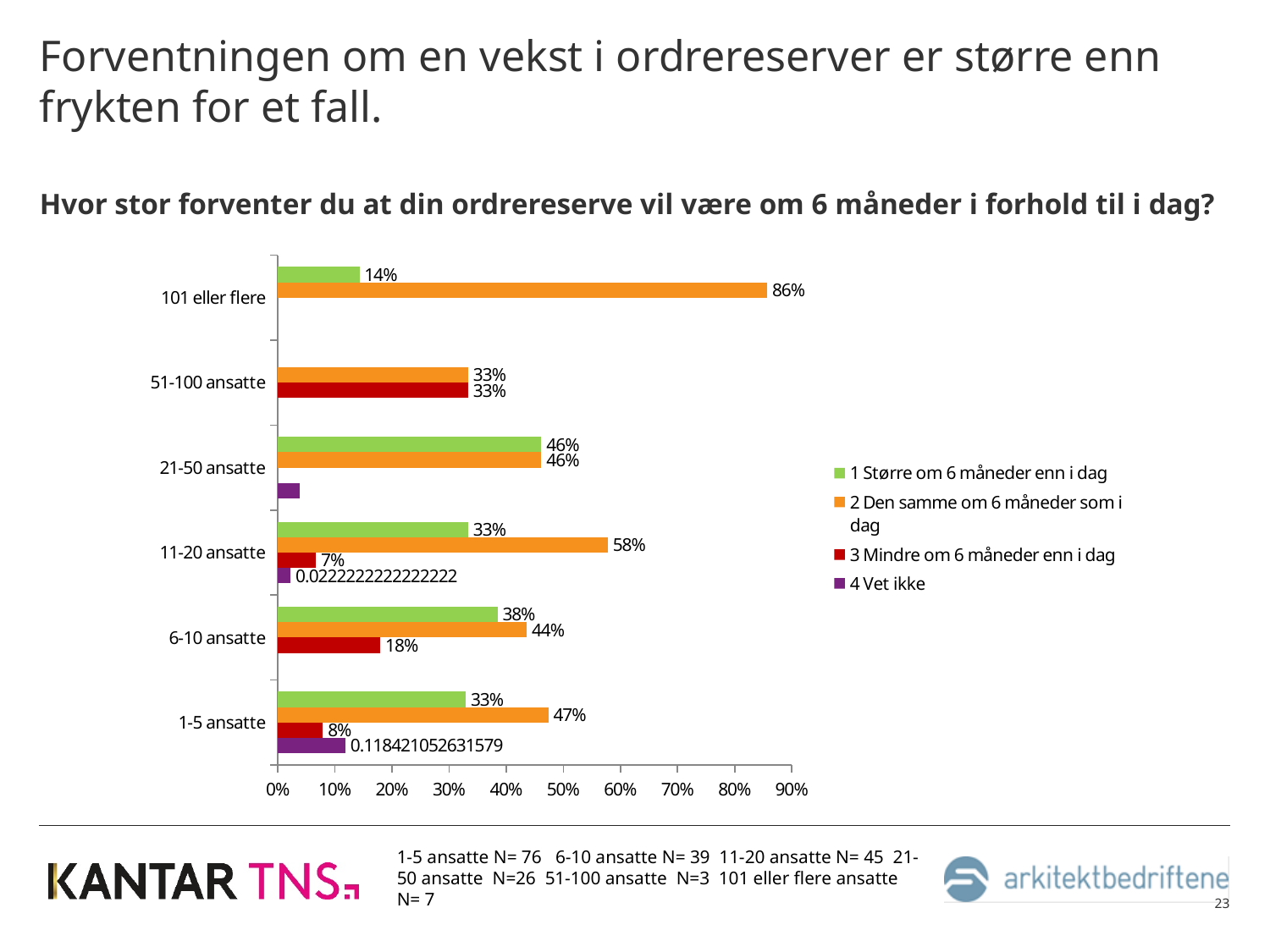
How many employee-size categories are shown on the chart? 6 How many series does the legend list? 4 Which category has the lowest value for "1 Større om 6 måneder enn i dag" among those with a labelled bar? 101 eller flere What is the value for "3 Mindre om 6 måneder enn i dag" for the "11-20 ansatte" category? 7% What is the value for "2 Den samme om 6 måneder som i dag" for the "101 eller flere" category? 86% For "6-10 ansatte", which is larger: "2 Den samme om 6 måneder som i dag" or "3 Mindre om 6 måneder enn i dag"? 2 Den samme om 6 måneder som i dag What is the difference between the "2 Den samme om 6 måneder som i dag" value and the "1 Større om 6 måneder enn i dag" value for "11-20 ansatte"? 25% What kind of chart is shown on the slide? Bar chart What is the data label shown for "4 Vet ikke" in the "1-5 ansatte" category? 0.118421052631579 Which category has the highest value for "2 Den samme om 6 måneder som i dag"? 101 eller flere What is the value for "1 Større om 6 måneder enn i dag" for the "6-10 ansatte" category? 38% Is the "4 Vet ikke" value for "21-50 ansatte" greater or less than 10%? less